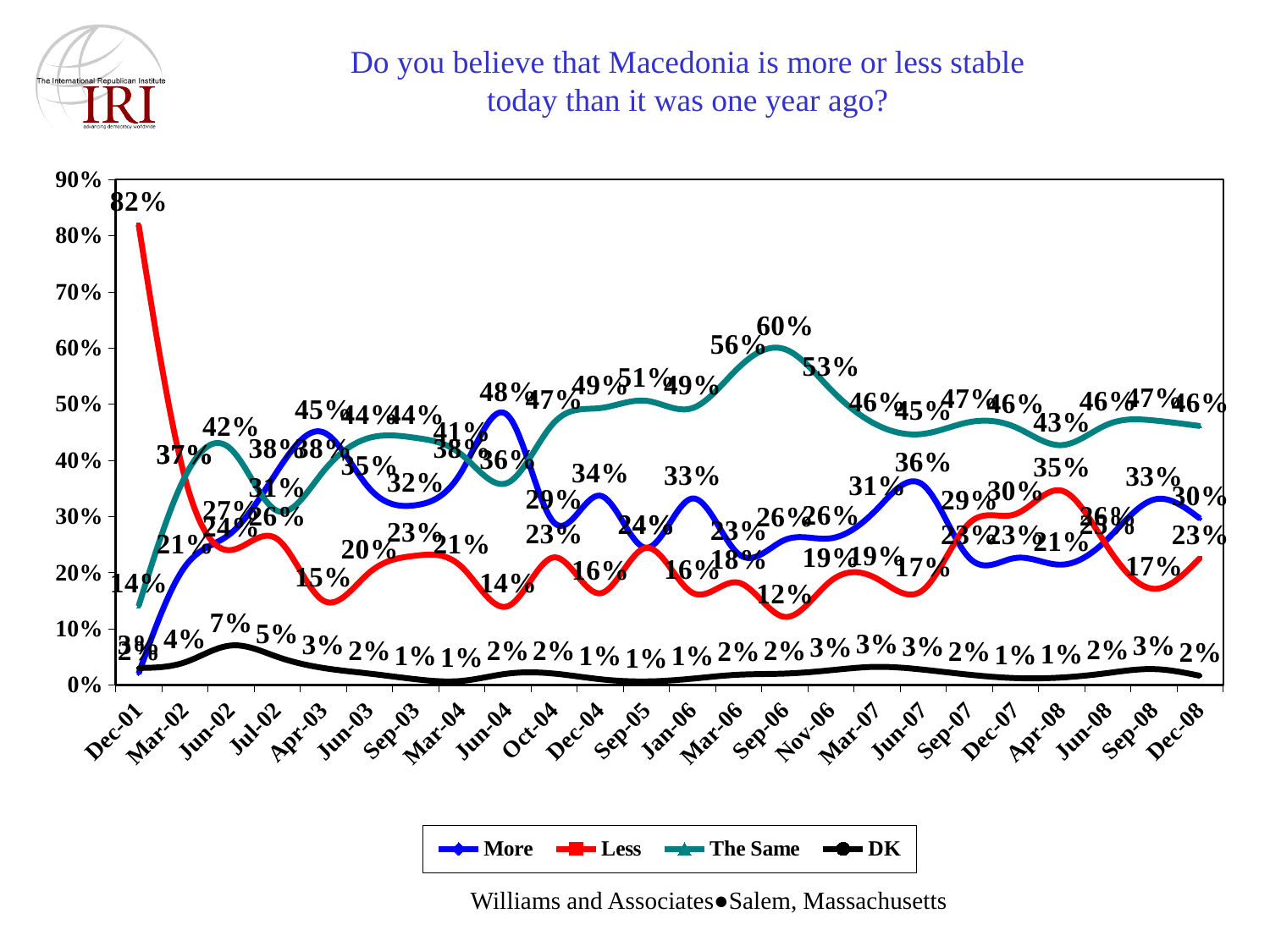
What kind of chart is shown on the slide? Line chart How many series does the legend list? 4 At which date does the Less series reach its highest value? Dec-01 What is the value for The Same series at Sep-06? 60% At Sep-06, which is larger: the value for The Same or the value for More? The Same What is the value for the Less series at Dec-01? 82% What is the value for the DK series at Jun-02? 7% What is the value for the More series at Jun-04? 48% What is the value for the Less series at Sep-06? 12% What is the difference between the Less value and The Same value at Dec-01? 68 percentage points Does the Less series rise or fall from Dec-01 to Jul-02? Fall At which date does The Same series reach its highest value? Sep-06